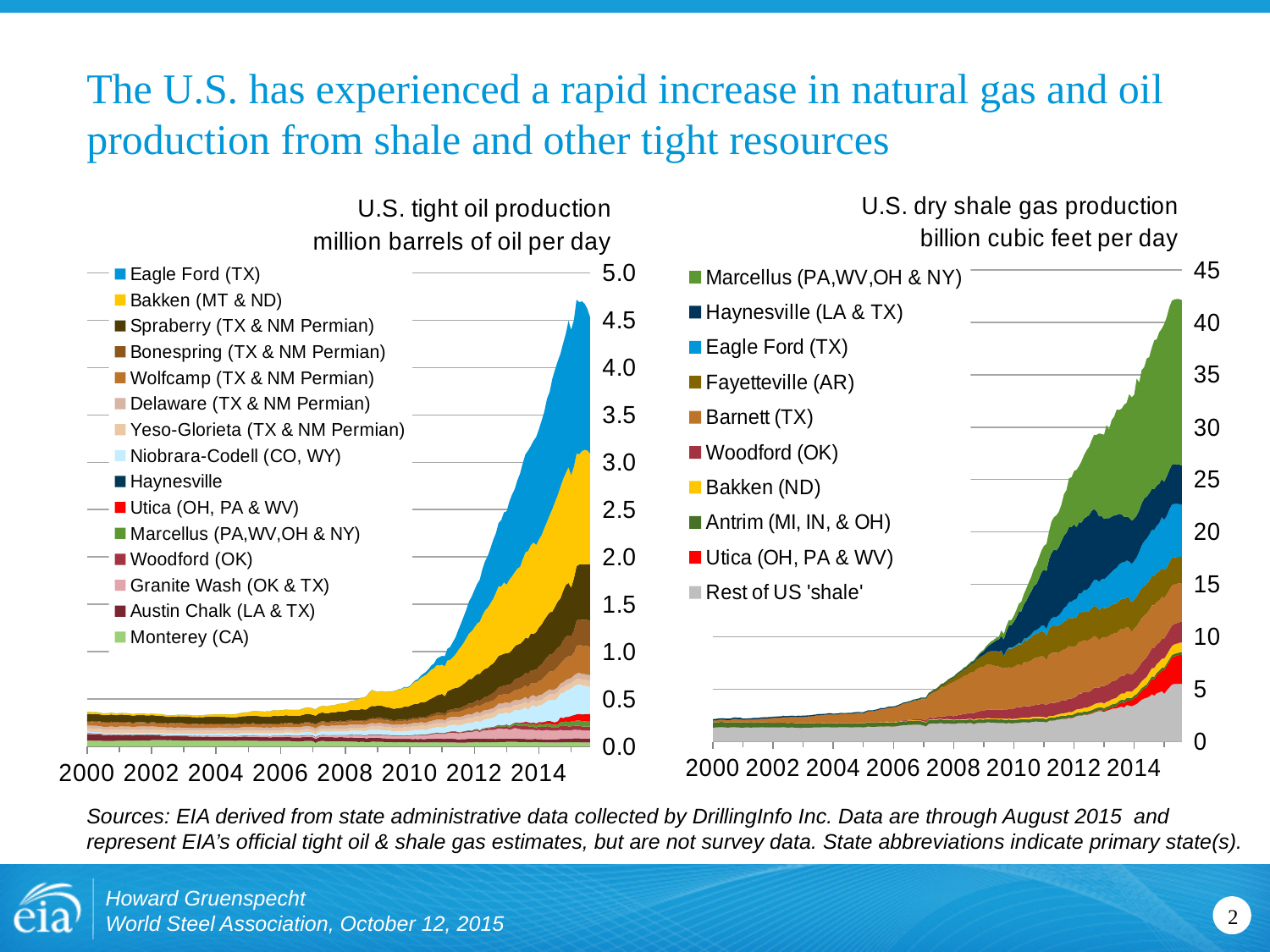
In the U.S. dry shale gas production chart, is the total production at the end of the series greater or less than 40 billion cubic feet per day? greater In the U.S. dry shale gas production chart, is the total production in 2000 greater or less than 5 billion cubic feet per day? less In the U.S. dry shale gas production chart, does total production rise or fall from 2000 to 2014? rise In the U.S. tight oil production chart, does total production rise or fall over the period shown? rise What unit is used on the U.S. dry shale gas production chart? billion cubic feet per day How many series does the legend of the U.S. dry shale gas production chart list? 10 What kind of chart is the U.S. tight oil production chart? stacked area chart In the U.S. tight oil production chart, is the total production in 2000 greater or less than 0.5 million barrels per day? less In the U.S. dry shale gas production chart, which play contributes the most production at the end of the series? Marcellus (PA,WV,OH & NY) How many series does the legend of the U.S. tight oil production chart list? 15 In the U.S. tight oil production chart, which play contributes the most production at the end of the series? Eagle Ford (TX)